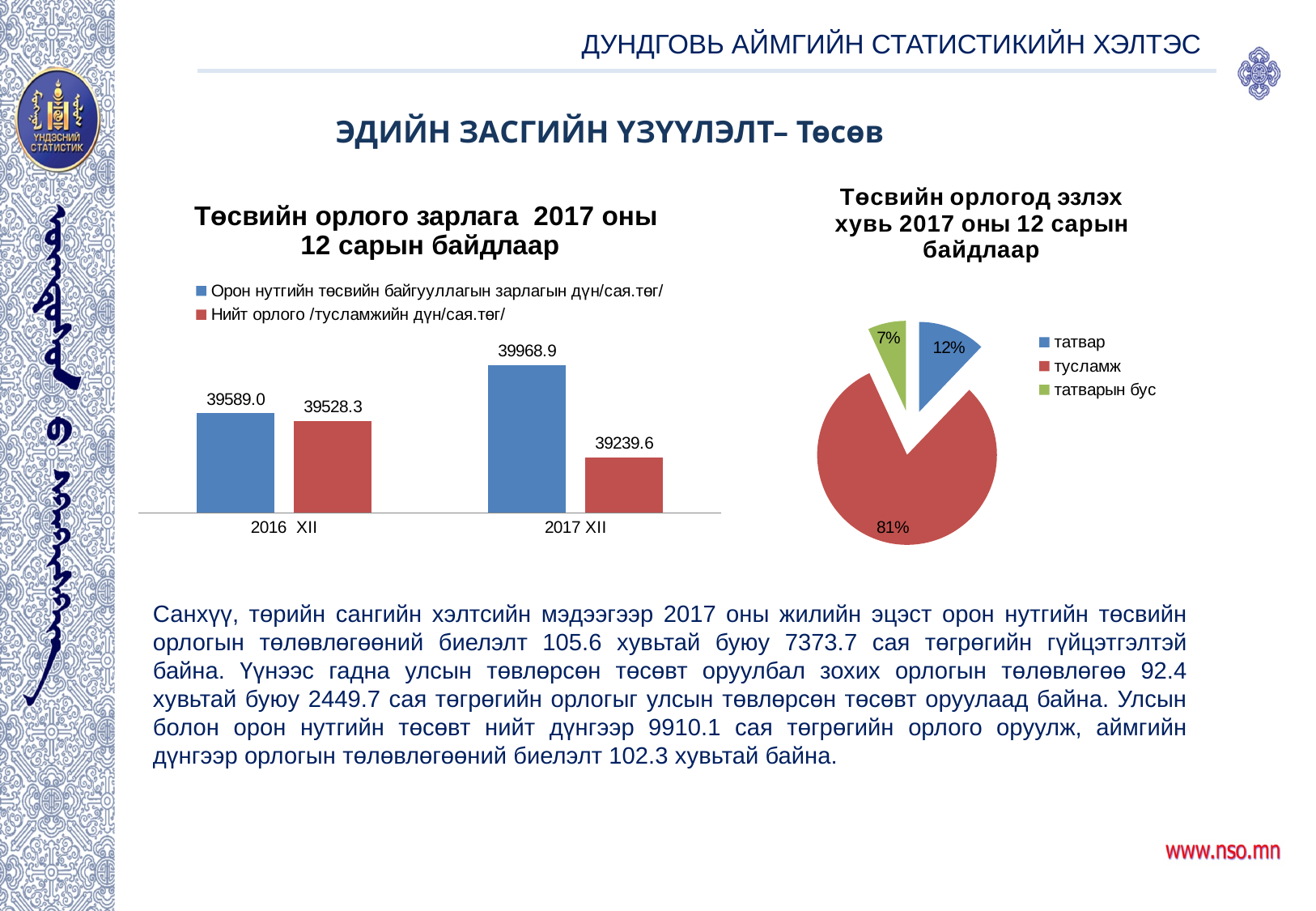
In the pie chart 'Төсвийн орлогод эзлэх хувь 2017 оны 12 сарын байдлаар', which slice is the largest? тусламж In the bar chart 'Төсвийн орлого зарлага 2017 оны 12 сарын байдлаар', which is larger for 2016 XII: 'Орон нутгийн төсвийн байгууллагын зарлагын дүн' or 'Нийт орлого /тусламжийн дүн'? Орон нутгийн төсвийн байгууллагын зарлагын дүн In the bar chart 'Төсвийн орлого зарлага 2017 оны 12 сарын байдлаар', how many series does the legend list? 2 In the bar chart 'Төсвийн орлого зарлага 2017 оны 12 сарын байдлаар', does 'Нийт орлого /тусламжийн дүн' rise or fall from 2016 XII to 2017 XII? fall In the pie chart 'Төсвийн орлогод эзлэх хувь 2017 оны 12 сарын байдлаар', what share does 'тусламж' have? 81% What type of chart is the chart on the right of the slide? pie chart In the bar chart 'Төсвийн орлого зарлага 2017 оны 12 сарын байдлаар', what is the value of 'Нийт орлого /тусламжийн дүн' for 2017 XII? 39239.6 In the bar chart 'Төсвийн орлого зарлага 2017 оны 12 сарын байдлаар', how many categories are shown on the x axis? 2 In the bar chart 'Төсвийн орлого зарлага 2017 оны 12 сарын байдлаар', what is the value of 'Нийт орлого /тусламжийн дүн' for 2016 XII? 39528.3 In the bar chart 'Төсвийн орлого зарлага 2017 оны 12 сарын байдлаар', what is the value of 'Орон нутгийн төсвийн байгууллагын зарлагын дүн' for 2017 XII? 39968.9 In the pie chart 'Төсвийн орлогод эзлэх хувь 2017 оны 12 сарын байдлаар', what share does 'татварын бус' have? 7% In the bar chart 'Төсвийн орлого зарлага 2017 оны 12 сарын байдлаар', what is the difference between the two bars for 2017 XII? 729.3